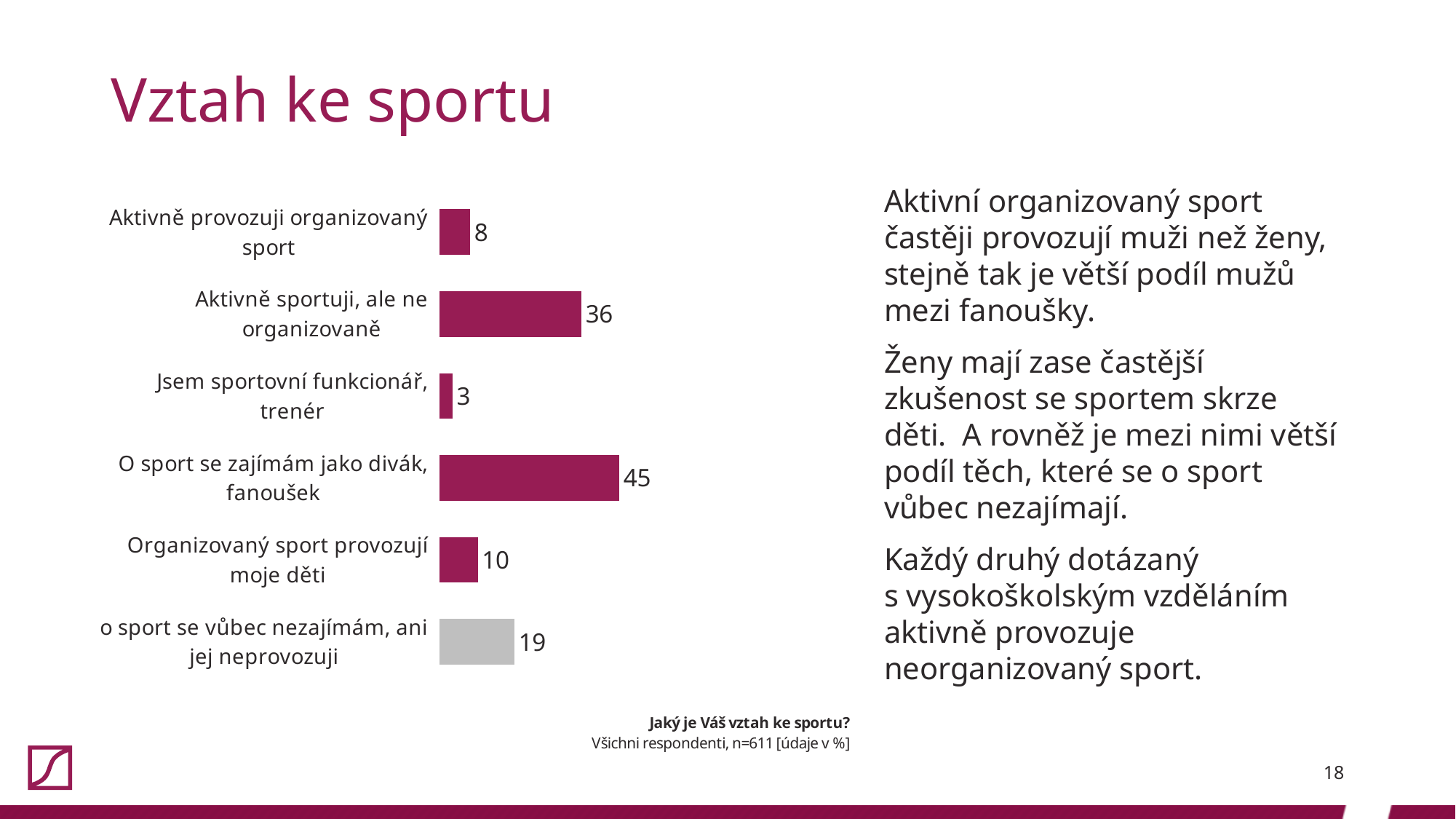
What is the difference between the values for "o sport se vůbec nezajímám, ani jej neprovozuji" and "Organizovaný sport provozují moje děti"? 9 Which bar is coloured grey rather than purple? o sport se vůbec nezajímám, ani jej neprovozuji Which category has the highest value? O sport se zajímám jako divák, fanoušek What value is shown for "Aktivně sportuji, ale ne organizovaně"? 36 What kind of chart is shown on the slide? Bar chart What is the difference between the values for "O sport se zajímám jako divák, fanoušek" and "Aktivně sportuji, ale ne organizovaně"? 9 How many categories does the chart show? 6 What value is shown for "o sport se vůbec nezajímám, ani jej neprovozuji"? 19 What value is shown for "Jsem sportovní funkcionář, trenér"? 3 Which is larger: the value for "Organizovaný sport provozují moje děti" or for "Aktivně provozuji organizovaný sport"? Organizovaný sport provozují moje děti What value is shown for "O sport se zajímám jako divák, fanoušek"? 45 Which category has the lowest value? Jsem sportovní funkcionář, trenér